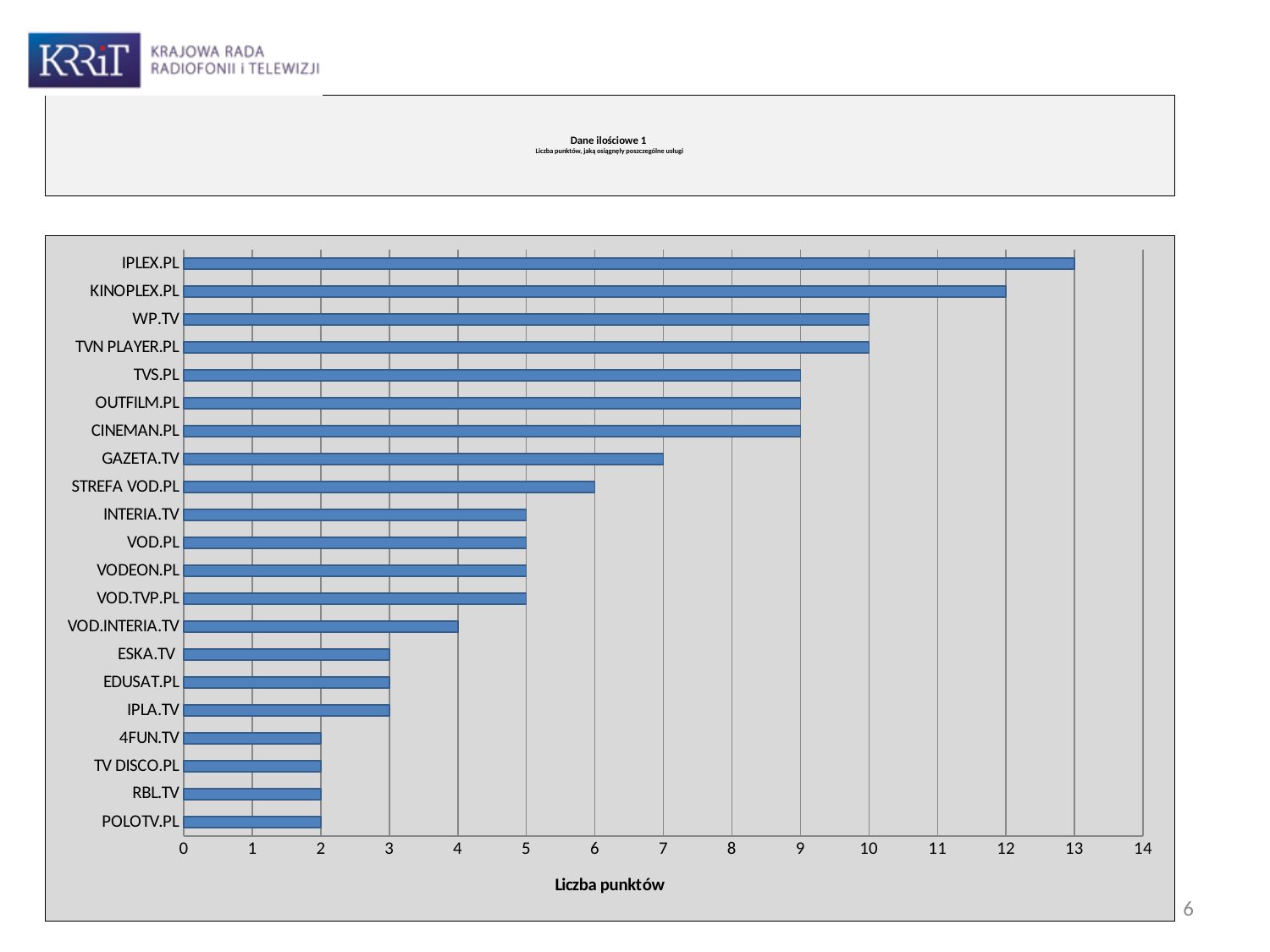
What is the value for VOD.INTERIA.TV? 4 Which has a larger value, TVS.PL or GAZETA.TV? TVS.PL How many points did IPLEX.PL achieve? 13 How many services (categories) are shown in the chart? 21 Which service has the highest number of points? IPLEX.PL What is the difference between the values for WP.TV and STREFA VOD.PL? 4 Is the value for KINOPLEX.PL greater or less than 10? greater What is the value for GAZETA.TV? 7 What kind of chart is shown on the slide? bar chart What is the label of the horizontal axis? Liczba punktów What is the difference in points between IPLEX.PL and KINOPLEX.PL? 1 Which has a larger value, ESKA.TV or VOD.PL? VOD.PL